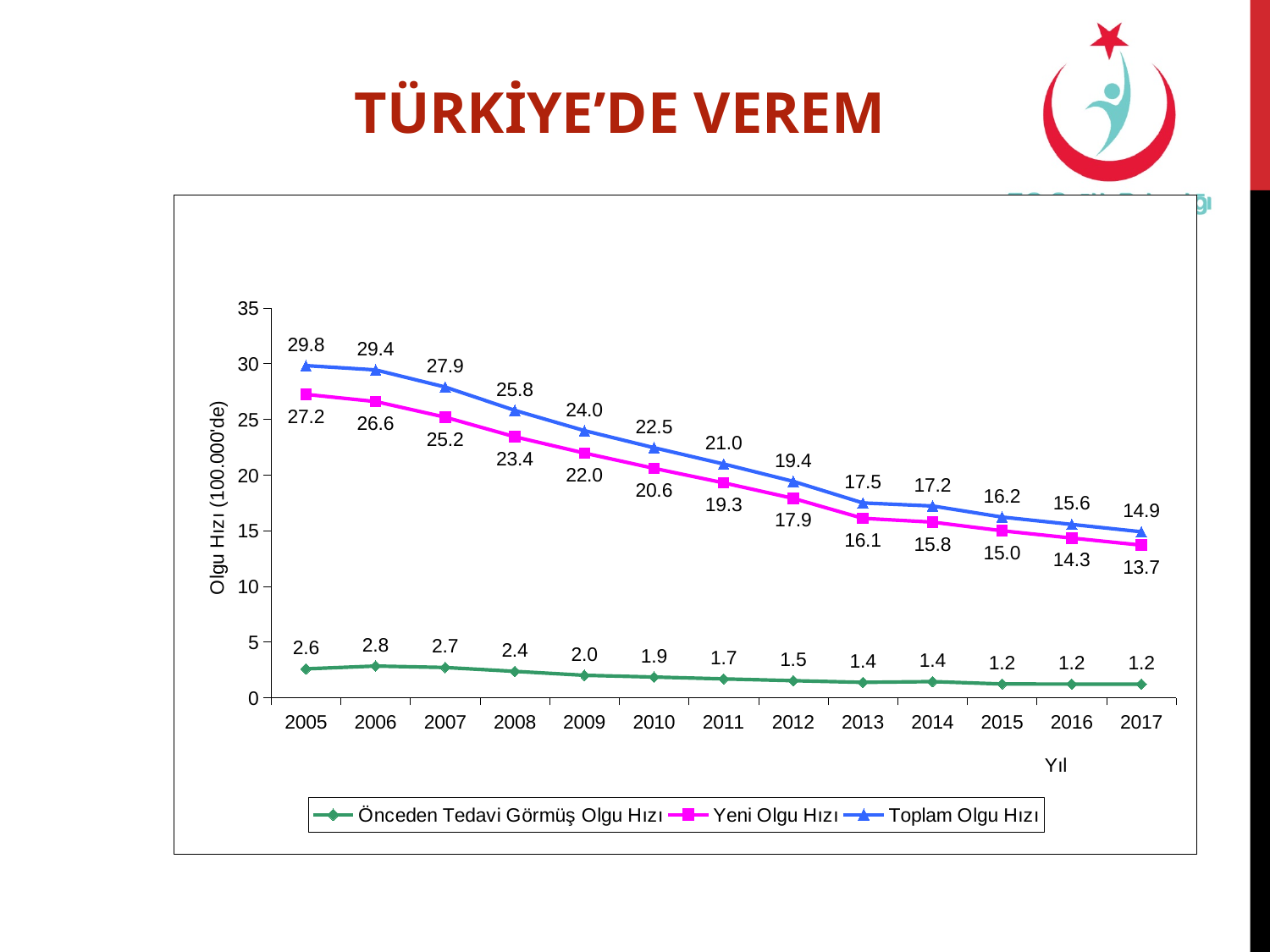
In which year is the Toplam Olgu Hızı highest? 2005 Does the Yeni Olgu Hızı rise or fall from 2005 to 2017? fall What is the Yeni Olgu Hızı value for 2012? 17.9 How many series does the legend list? 3 What kind of chart is shown on the slide? line chart Is the Toplam Olgu Hızı for 2013 greater or less than 15? greater In which year is the Yeni Olgu Hızı lowest? 2017 What is the difference between the Toplam Olgu Hızı and the Yeni Olgu Hızı in 2017? 1.2 What is the Önceden Tedavi Görmüş Olgu Hızı value for 2009? 2.0 Which is larger, the Toplam Olgu Hızı in 2010 or in 2011? 2010 What is the Toplam Olgu Hızı value for 2005? 29.8 How many years are shown on the x axis? 13